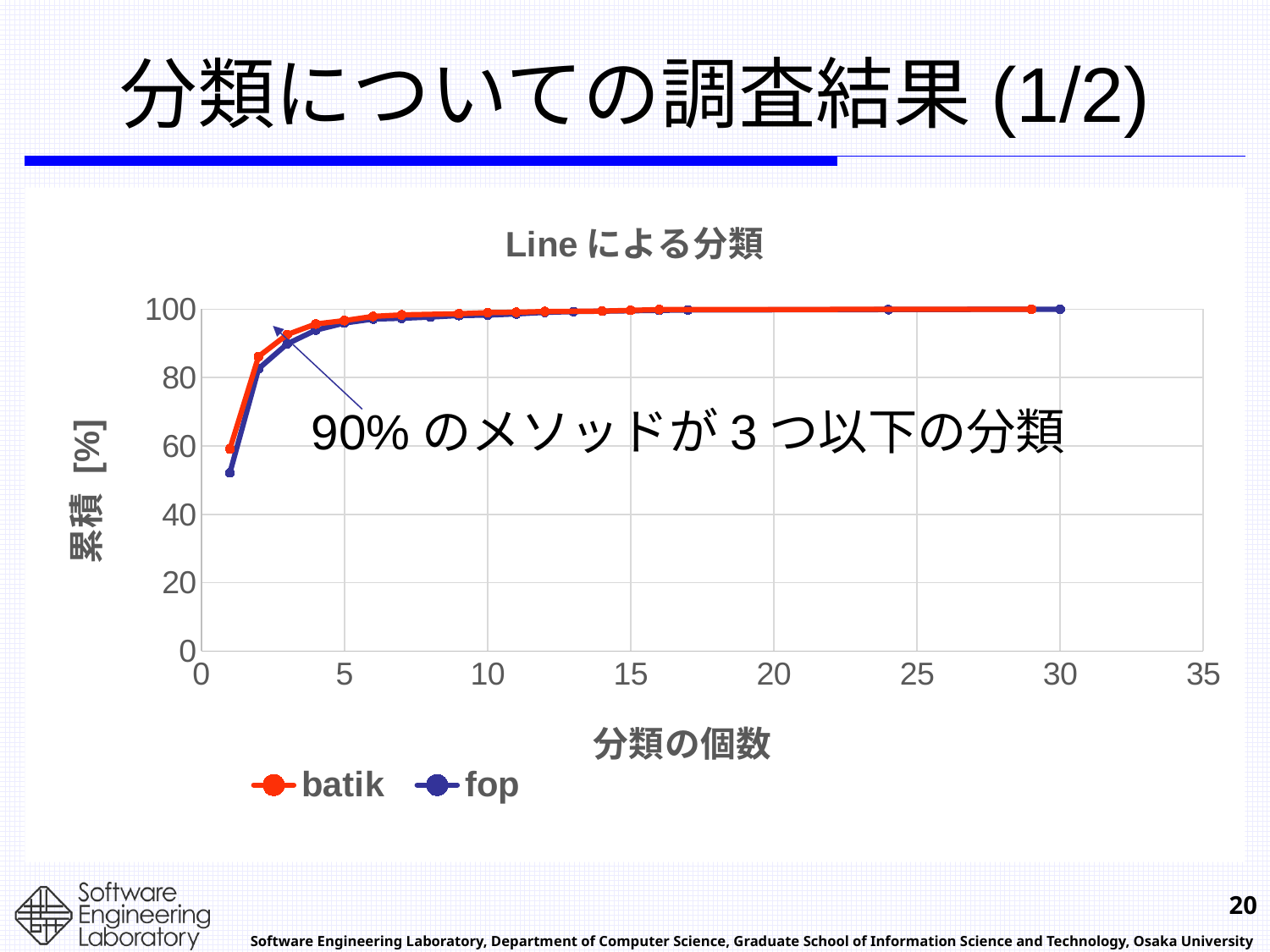
Is the value for batik at 5 categories greater or less than 80? greater Is the value for fop at 1 category greater or less than 60? less What is the title of the chart? Line による分類 What are the names of the two series in the legend? batik and fop Is the value for fop at 1 category greater or less than 40? greater How many series does the legend list? 2 Do the values for fop rise or fall as the number of categories (分類の個数) increases along the x axis? rise Do the values for batik rise or fall as the number of categories (分類の個数) increases along the x axis? rise At 1 category, which series has the higher cumulative value, batik or fop? batik What kind of chart is shown on the slide? line chart